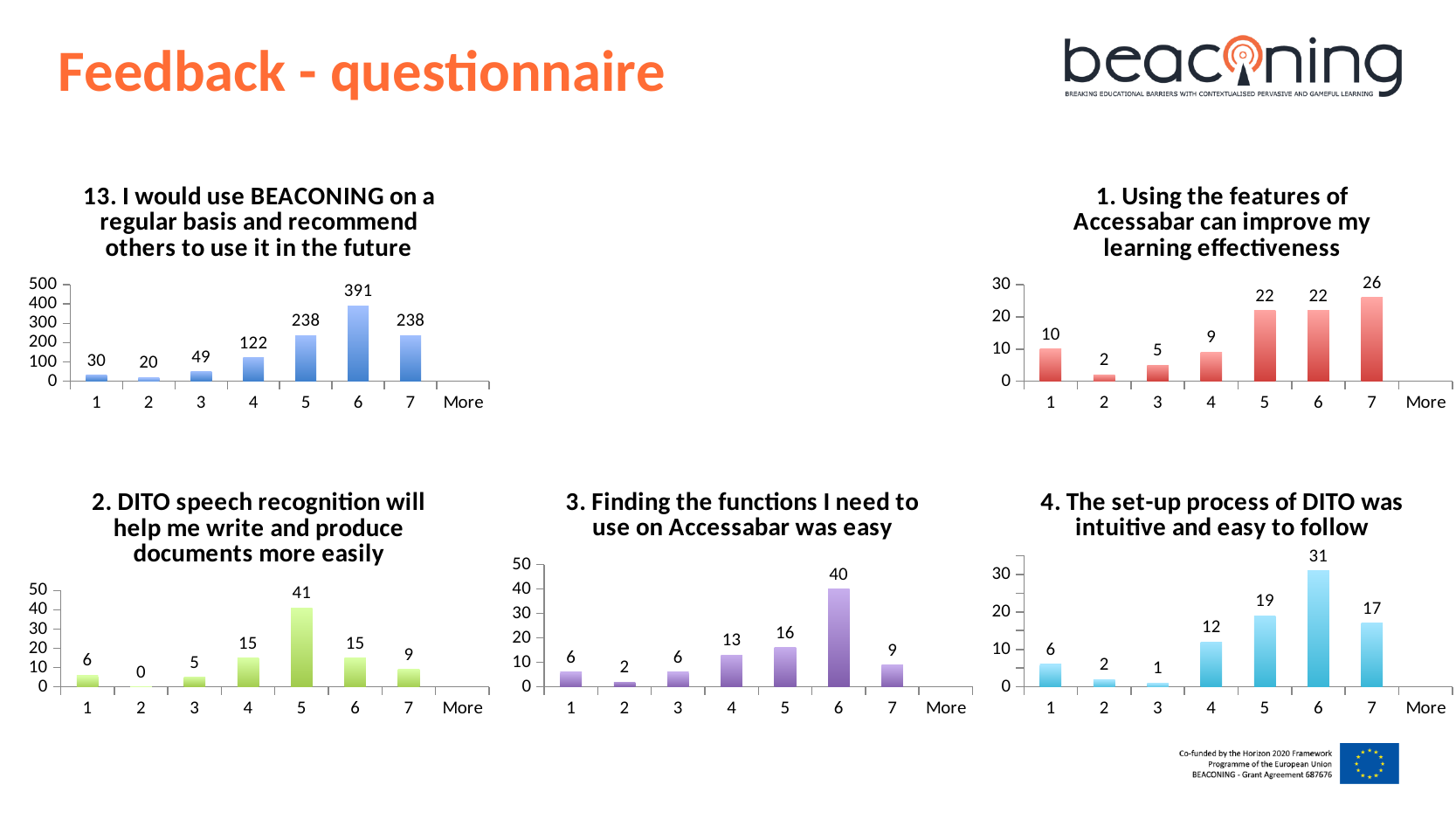
In the chart titled "2. DITO speech recognition will help me write and produce documents more easily", which category has the lowest value? 2 In the chart titled "13. I would use BEACONING on a regular basis and recommend others to use it in the future", what is the difference between the values for categories 6 and 5? 153 In the chart titled "4. The set-up process of DITO was intuitive and easy to follow", what is the value for category 6? 31 What kind of chart is the one titled "4. The set-up process of DITO was intuitive and easy to follow"? Bar chart In the chart titled "3. Finding the functions I need to use on Accessabar was easy", which is larger: the value for category 5 or category 6? 6 In the chart titled "1. Using the features of Accessabar can improve my learning effectiveness", what is the value for category 2? 2 In the chart titled "4. The set-up process of DITO was intuitive and easy to follow", what is the difference between the values for categories 5 and 7? 2 In the chart titled "1. Using the features of Accessabar can improve my learning effectiveness", which category has the highest value? 7 In the chart titled "3. Finding the functions I need to use on Accessabar was easy", what is the value for category 4? 13 How many charts are shown on the slide? 5 In the chart titled "2. DITO speech recognition will help me write and produce documents more easily", what is the value for category 5? 41 In the chart titled "13. I would use BEACONING on a regular basis and recommend others to use it in the future", what is the value for category 6? 391